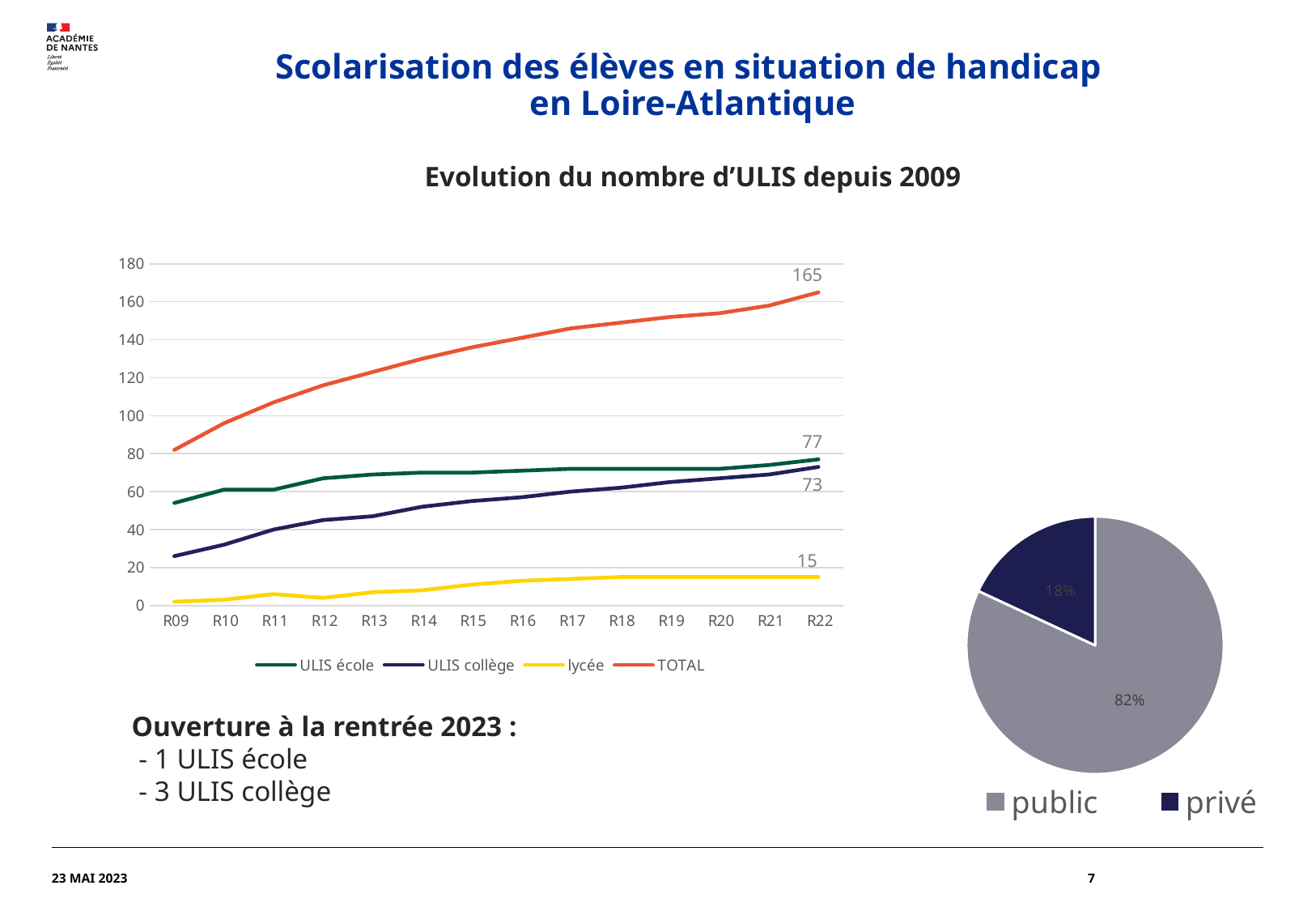
In the line chart 'Evolution du nombre d'ULIS depuis 2009', what is the value of ULIS école at R22? 77 In the line chart 'Evolution du nombre d'ULIS depuis 2009', how many points are on the x axis? 14 In the line chart 'Evolution du nombre d'ULIS depuis 2009', which series has the lowest values across all years? lycée In the line chart 'Evolution du nombre d'ULIS depuis 2009', does the TOTAL series rise or fall from R09 to R22? rise In the line chart 'Evolution du nombre d'ULIS depuis 2009', what is the value of ULIS collège at R22? 73 In the line chart 'Evolution du nombre d'ULIS depuis 2009', what is the difference between ULIS école and ULIS collège at R22? 4 In the line chart 'Evolution du nombre d'ULIS depuis 2009', what is the value of lycée at R22? 15 In the line chart 'Evolution du nombre d'ULIS depuis 2009', how many series does the legend list? 4 In the pie chart on the right, what share does privé have? 18% In the line chart 'Evolution du nombre d'ULIS depuis 2009', is the value of TOTAL at R09 greater or less than 100? less In the line chart 'Evolution du nombre d'ULIS depuis 2009', what is the value of TOTAL at R22? 165 In the pie chart on the right, what share does public have? 82%